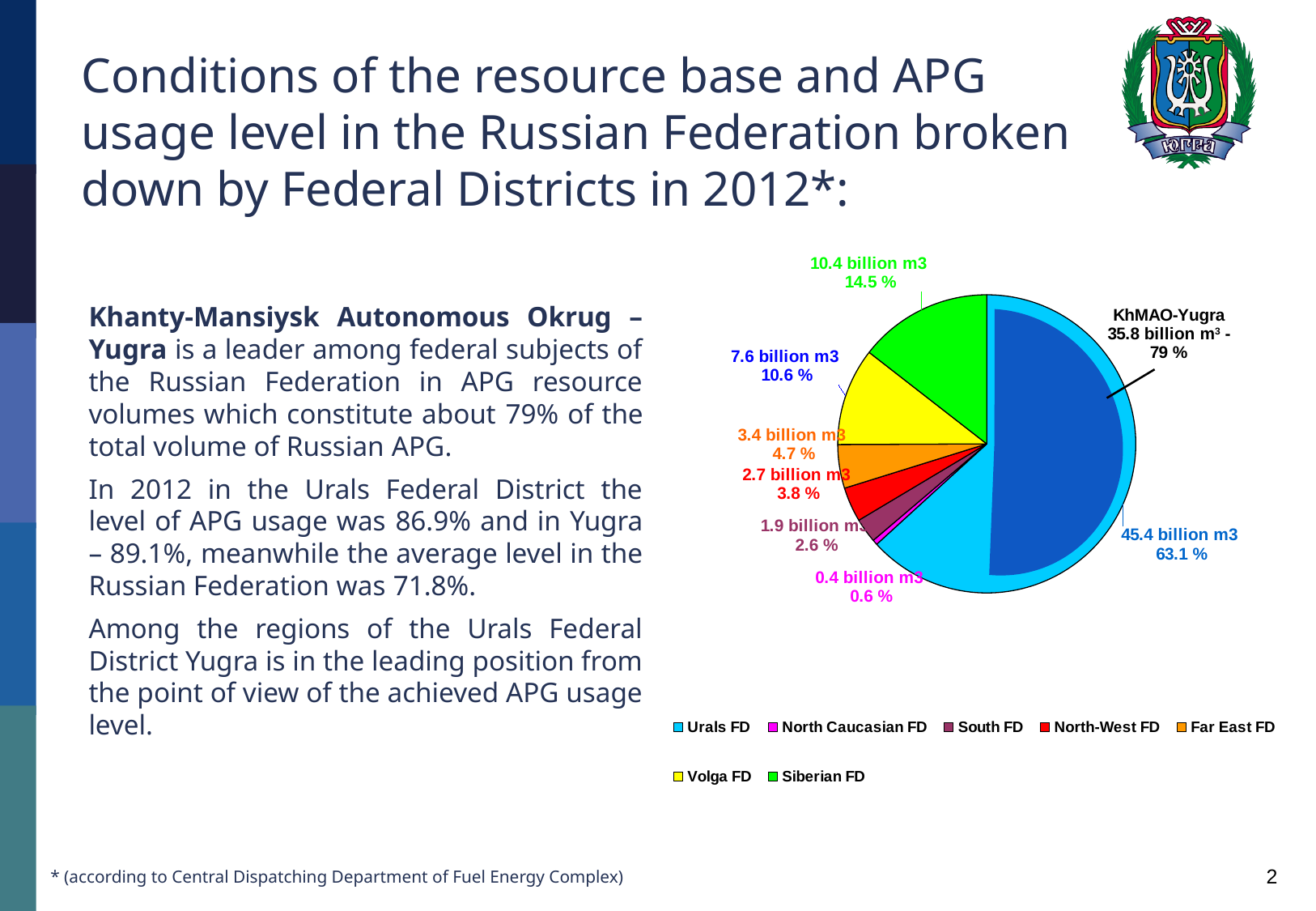
How many federal districts does the legend of the pie chart list? 7 Which federal district has the largest slice of the pie? Urals FD What percentage is shown for the South FD slice? 2.6 % What volume is shown for the Siberian FD slice? 10.4 billion m3 Which slice is larger, Far East FD or North-West FD? Far East FD What kind of chart is shown on the slide? pie chart What volume and share are shown for KhMAO-Yugra within the Urals FD slice? 35.8 billion m³ - 79 % Which federal district has the smallest slice of the pie? North Caucasian FD What share of the pie does the Urals FD slice represent? 63.1 % What is the difference in volume between the Siberian FD and Volga FD slices? 2.8 billion m3 What volume is shown for the Urals FD slice of the pie chart? 45.4 billion m3 What percentage is shown for the Volga FD slice? 10.6 %